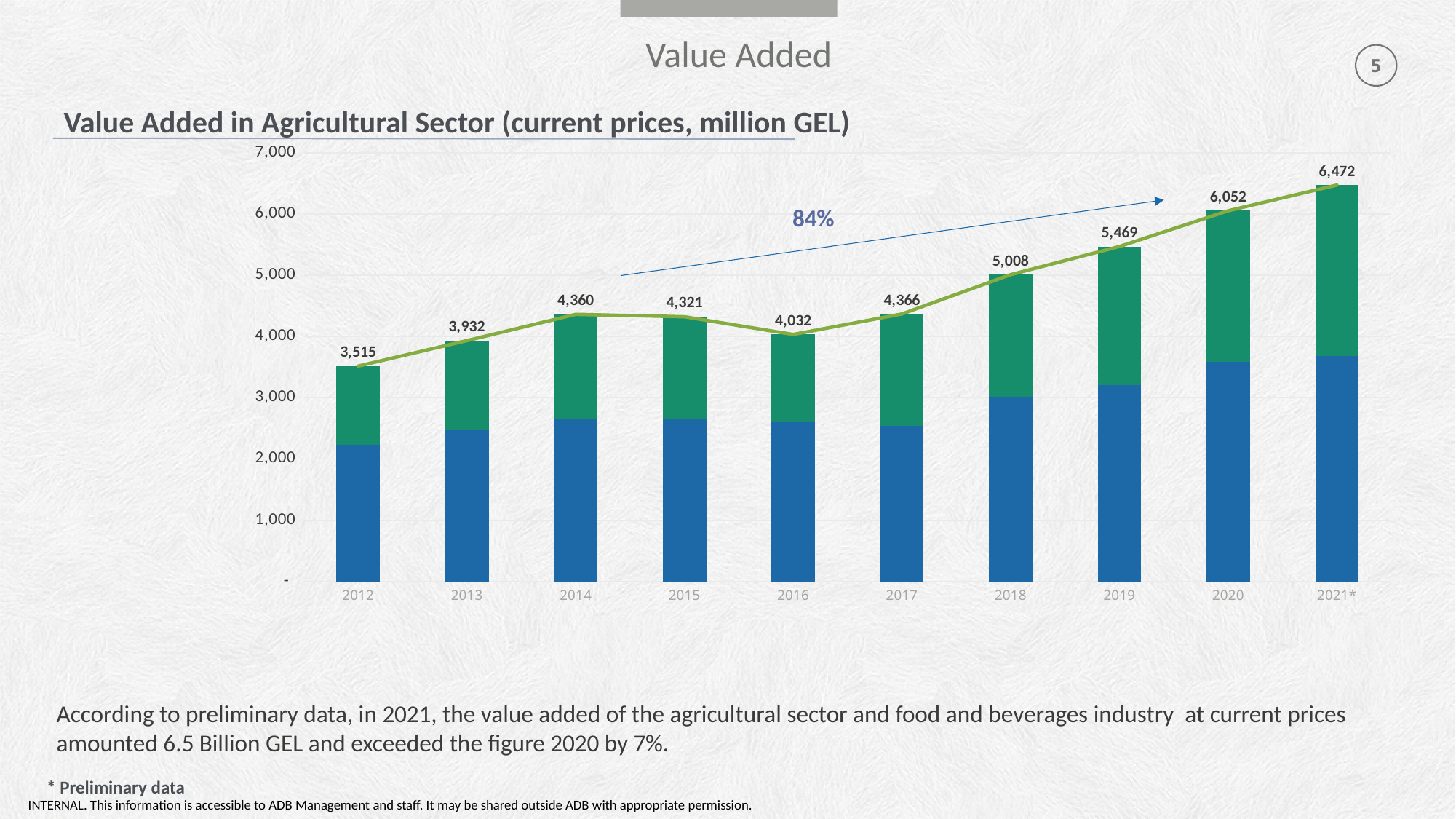
What percentage growth is annotated by the arrow on the chart? 84% What kind of chart is used to show the value added in the agricultural sector? Stacked bar chart with a line What is the difference between the total value added in 2021* and in 2020? 420 Is the value of the blue (bottom) segment for 2012 greater or less than 3,000? less What is the total value added shown for 2021*? 6,472 Which year has the lowest total value added? 2012 What is the total value added shown for 2018? 5,008 Is the value of the blue (bottom) segment for 2020 greater or less than 3,000? greater What is the total value added in the agricultural sector for 2012? 3,515 Which year has the highest total value added? 2021* How many years are shown on the x axis of the chart? 10 Which year has a larger total value added, 2014 or 2015? 2014